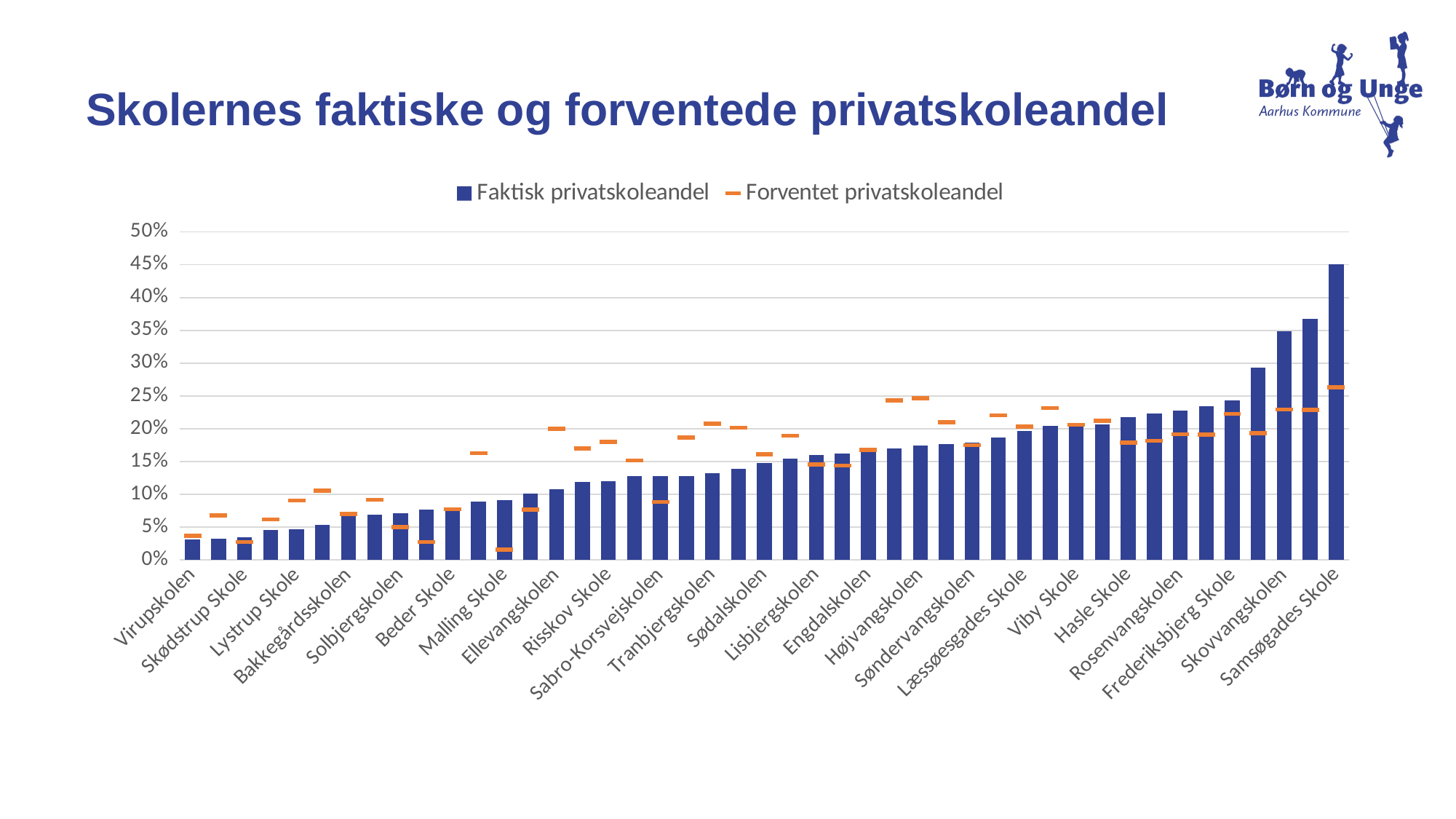
Is the Faktisk privatskoleandel for Virupskolen greater or less than 5%? less How many series does the legend list? 2 Is the Faktisk privatskoleandel for Frederiksbjerg Skole greater or less than 20%? greater Do the Faktisk privatskoleandel bars rise or fall from left to right along the x axis? rise What are the two series named in the legend? Faktisk privatskoleandel and Forventet privatskoleandel Is the Faktisk privatskoleandel for Samsøgades Skole greater or less than 40%? greater What is the title of the chart? Skolernes faktiske og forventede privatskoleandel What kind of chart is shown on the slide? bar chart Which school has the highest Faktisk privatskoleandel? Samsøgades Skole Which has the larger Faktisk privatskoleandel, Virupskolen or Frederiksbjerg Skole? Frederiksbjerg Skole